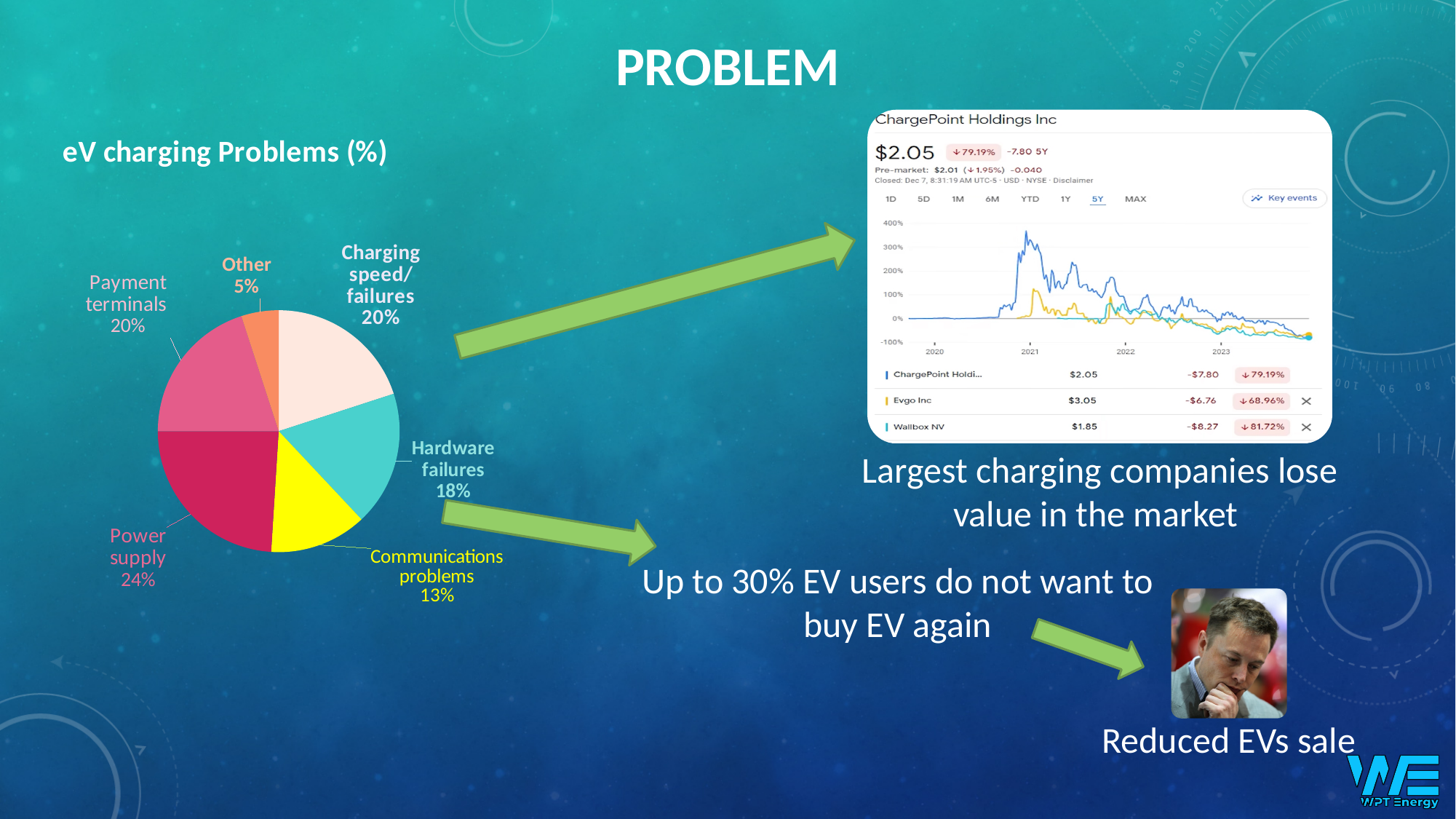
In the pie chart 'eV charging Problems (%)', what is the difference in percentage points between Power supply and Communications problems? 11 How many categories does the pie chart 'eV charging Problems (%)' show? 6 In the ChargePoint Holdings Inc chart on the right, what 5-year percentage change is shown for Wallbox NV? -81.72% What kind of chart is 'eV charging Problems (%)'? Pie chart In the pie chart 'eV charging Problems (%)', which category has the smallest share? Other In the pie chart 'eV charging Problems (%)', which category has the largest share? Power supply In the pie chart 'eV charging Problems (%)', which is larger: Hardware failures or Charging speed/failures? Charging speed/failures In the pie chart 'eV charging Problems (%)', what share is attributed to Hardware failures? 18% In the ChargePoint Holdings Inc chart on the right, what is the current price shown for ChargePoint? $2.05 In the pie chart 'eV charging Problems (%)', what share is attributed to Power supply? 24% What kind of chart is the ChargePoint Holdings Inc chart on the right? Line chart In the pie chart 'eV charging Problems (%)', what share is attributed to Communications problems? 13%